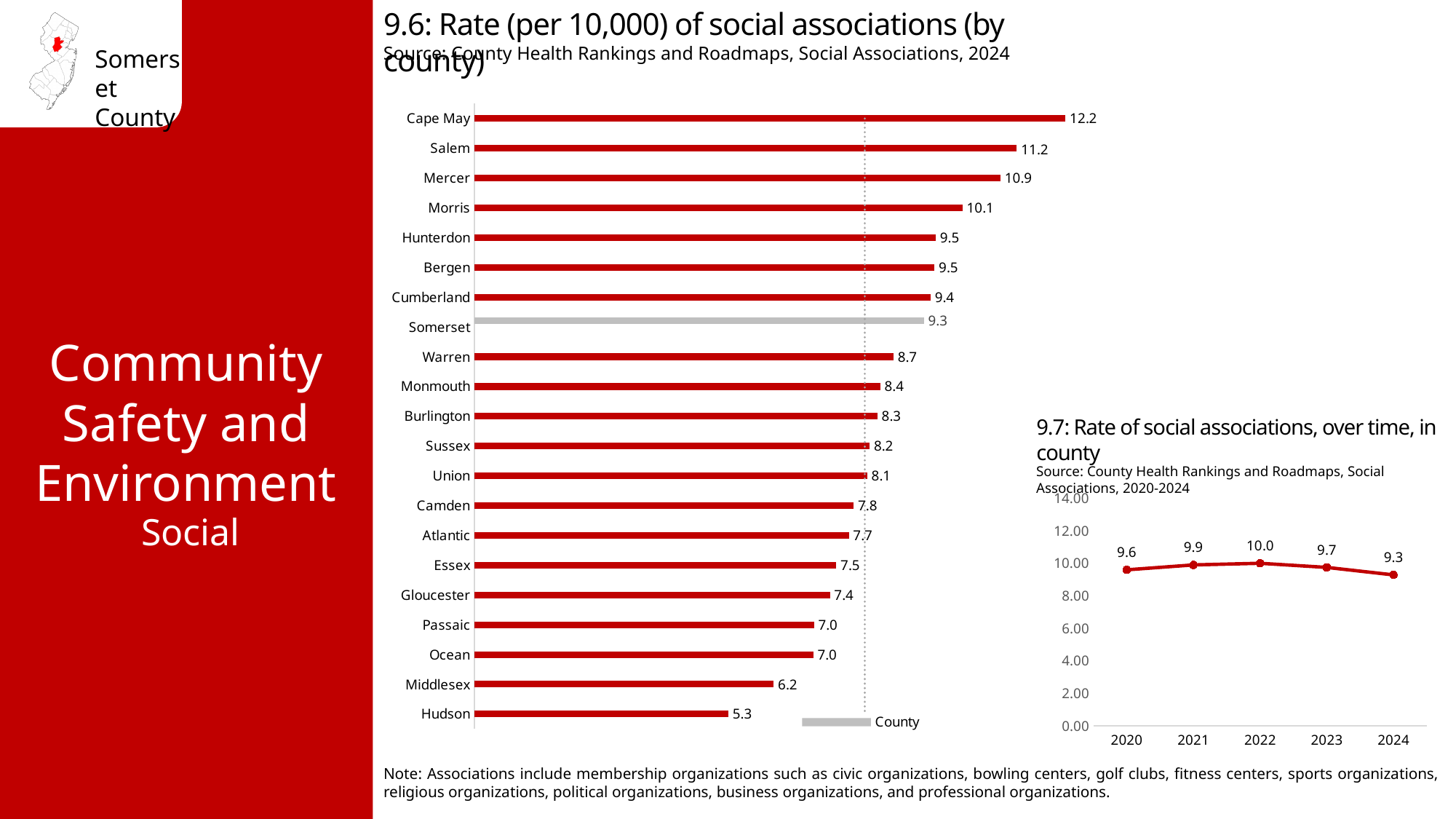
In chart 9.7 (rate of social associations over time), how many years are plotted? 5 In chart 9.7 (rate of social associations over time), what is the difference between the 2022 and 2024 values? 0.7 In chart 9.6 (rate of social associations by county), which county has the lowest rate? Hudson In chart 9.7 (rate of social associations over time), what is the value for 2022? 10.0 In chart 9.7 (rate of social associations over time), which year has the lowest value? 2024 In chart 9.6 (rate of social associations by county), which county has the highest rate? Cape May In chart 9.6 (rate of social associations by county), what is the value for Mercer? 10.9 In chart 9.6 (rate of social associations by county), which is larger, Morris or Warren? Morris In chart 9.6 (rate of social associations by county), what is the value for Somerset? 9.3 In chart 9.6 (rate of social associations by county), what is the difference between Cape May and Hudson? 6.9 What kind of chart is chart 9.6 (rate of social associations by county)? Bar chart In chart 9.6 (rate of social associations by county), how many counties are shown? 21